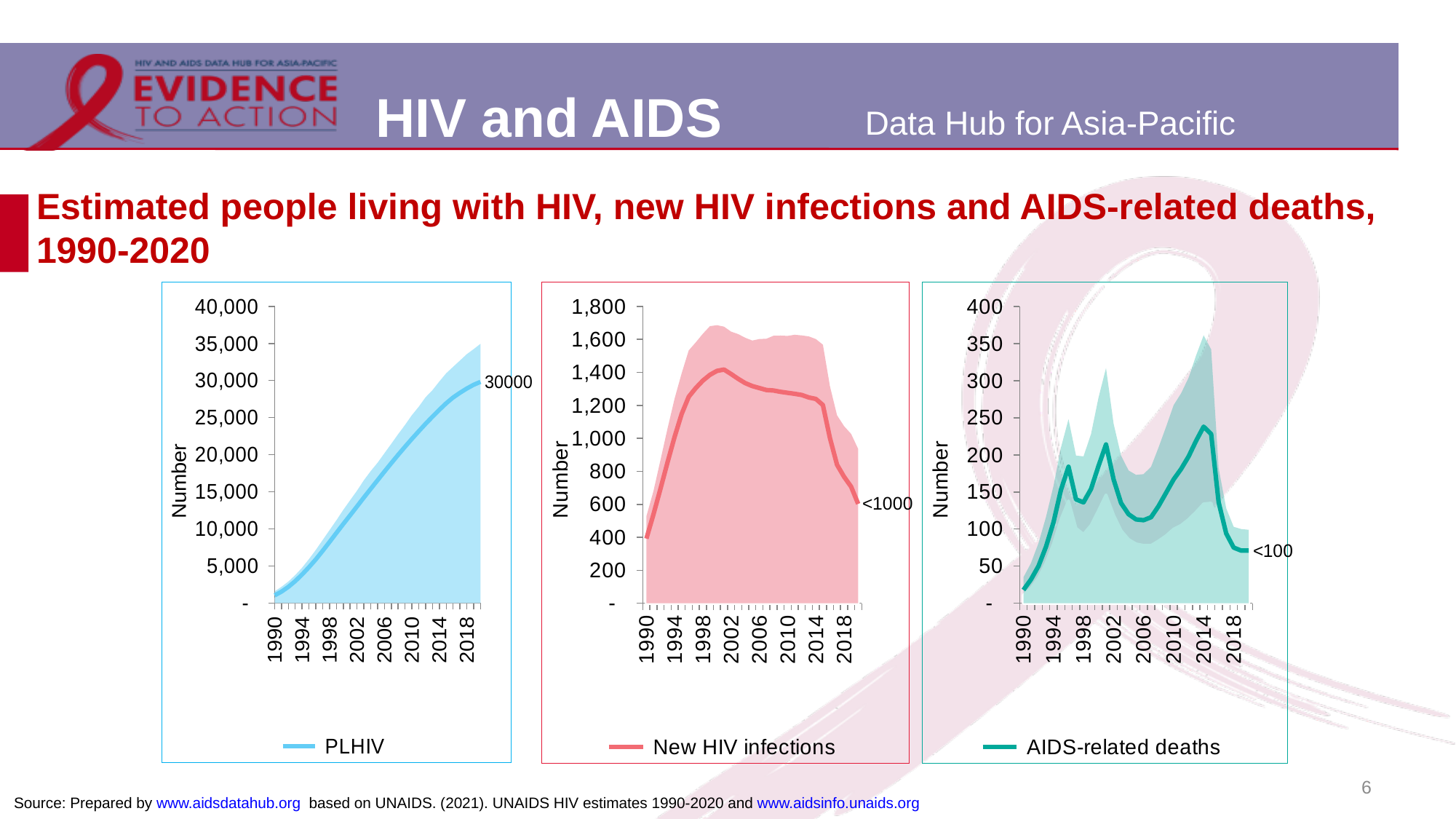
In the left chart (PLHIV), does the line rise or fall from 1990 to 2020? rise In the left chart (PLHIV), is the value for 2006 greater or less than 20,000? less What type of chart is the left chart (PLHIV)? area and line chart (a line with a shaded area band) What is the legend entry of the middle chart? New HIV infections In the middle chart (New HIV infections), does the line rise or fall from 2000 to 2020? fall In the middle chart (New HIV infections), is the value for 1990 greater or less than 600? less In the middle chart (New HIV infections), what is the data label shown at the end of the line in 2020? <1000 In the right chart (AIDS-related deaths), is the value for 2014 greater or less than 200? greater In the right chart (AIDS-related deaths), what is the data label shown at the end of the line in 2020? <100 How many series does the legend of the right chart list? 1 In the left chart (PLHIV), what is the data label shown at the end of the line in 2020? 30000